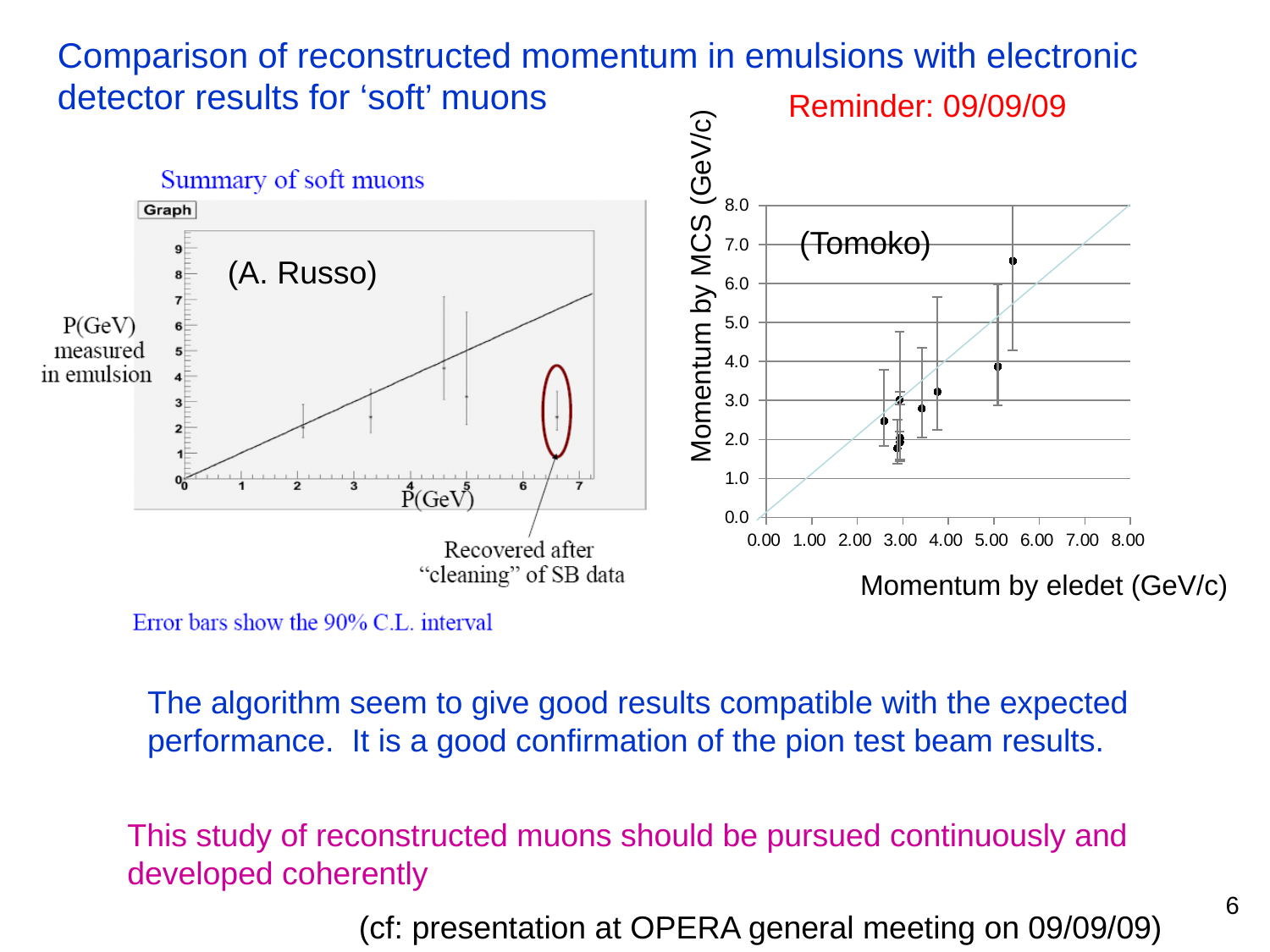
In the right-hand chart (Tomoko), what is the maximum value shown on the y axis? 8.0 In the right-hand chart (Tomoko), what is the label of the x axis? Momentum by eledet (GeV/c) What kind of chart is the right-hand chart (Tomoko)? Scatter plot In the right-hand chart (Tomoko), is the momentum by MCS of the point at about 5.00 GeV/c eledet momentum greater or less than 5.0? less In the right-hand chart (Tomoko), do the momentum by MCS values generally rise or fall as the momentum by eledet increases? rise In the left-hand chart 'Summary of soft muons', is the emulsion momentum of the circled point (recovered after cleaning of SB data) greater or less than 3 GeV? less In the right-hand chart (Tomoko), what is the label of the y axis? Momentum by MCS (GeV/c) How many data points are plotted in the left-hand chart 'Summary of soft muons'? 5 What kind of chart is the left-hand chart titled 'Summary of soft muons'? Scatter plot with error bars